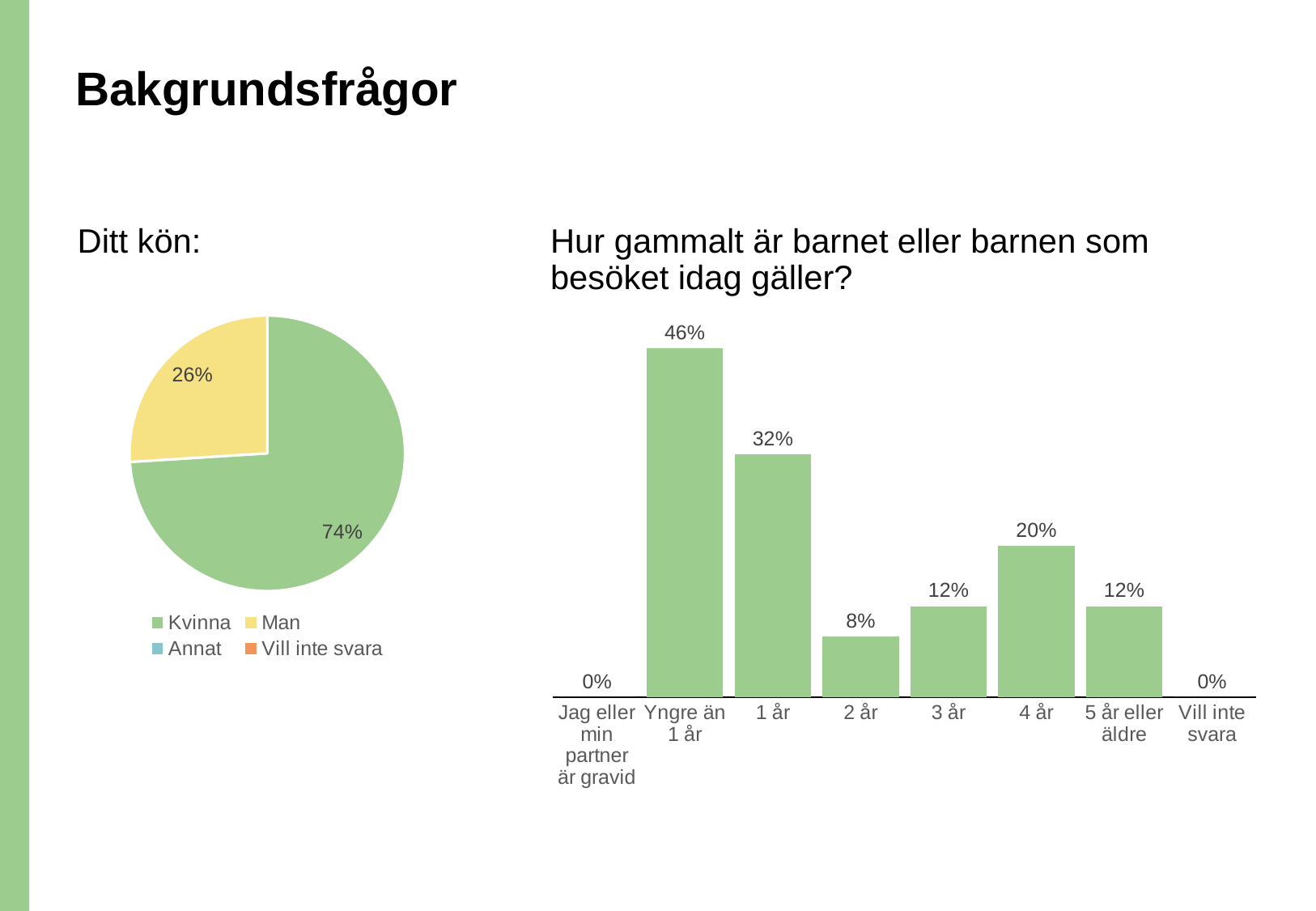
In the chart "Hur gammalt är barnet eller barnen som besöket idag gäller?", which is larger, 2 år or 3 år? 3 år In the "Ditt kön:" pie chart, how many entries does the legend list? 4 What kind of chart is the "Ditt kön:" chart? Pie chart In the chart "Hur gammalt är barnet eller barnen som besöket idag gäller?", how many categories are shown on the x axis? 8 In the "Ditt kön:" pie chart, what is the difference between the Kvinna and Man shares? 48% In the "Ditt kön:" pie chart, what share is Kvinna? 74% In the chart "Hur gammalt är barnet eller barnen som besöket idag gäller?", what is the value for 1 år? 32% In the chart "Hur gammalt är barnet eller barnen som besöket idag gäller?", what is the difference between Yngre än 1 år and 1 år? 14% What kind of chart is "Hur gammalt är barnet eller barnen som besöket idag gäller?"? Bar chart In the chart "Hur gammalt är barnet eller barnen som besöket idag gäller?", what is the value for 4 år? 20% In the chart "Hur gammalt är barnet eller barnen som besöket idag gäller?", which category has the highest value? Yngre än 1 år In the "Ditt kön:" pie chart, what share is Man? 26%